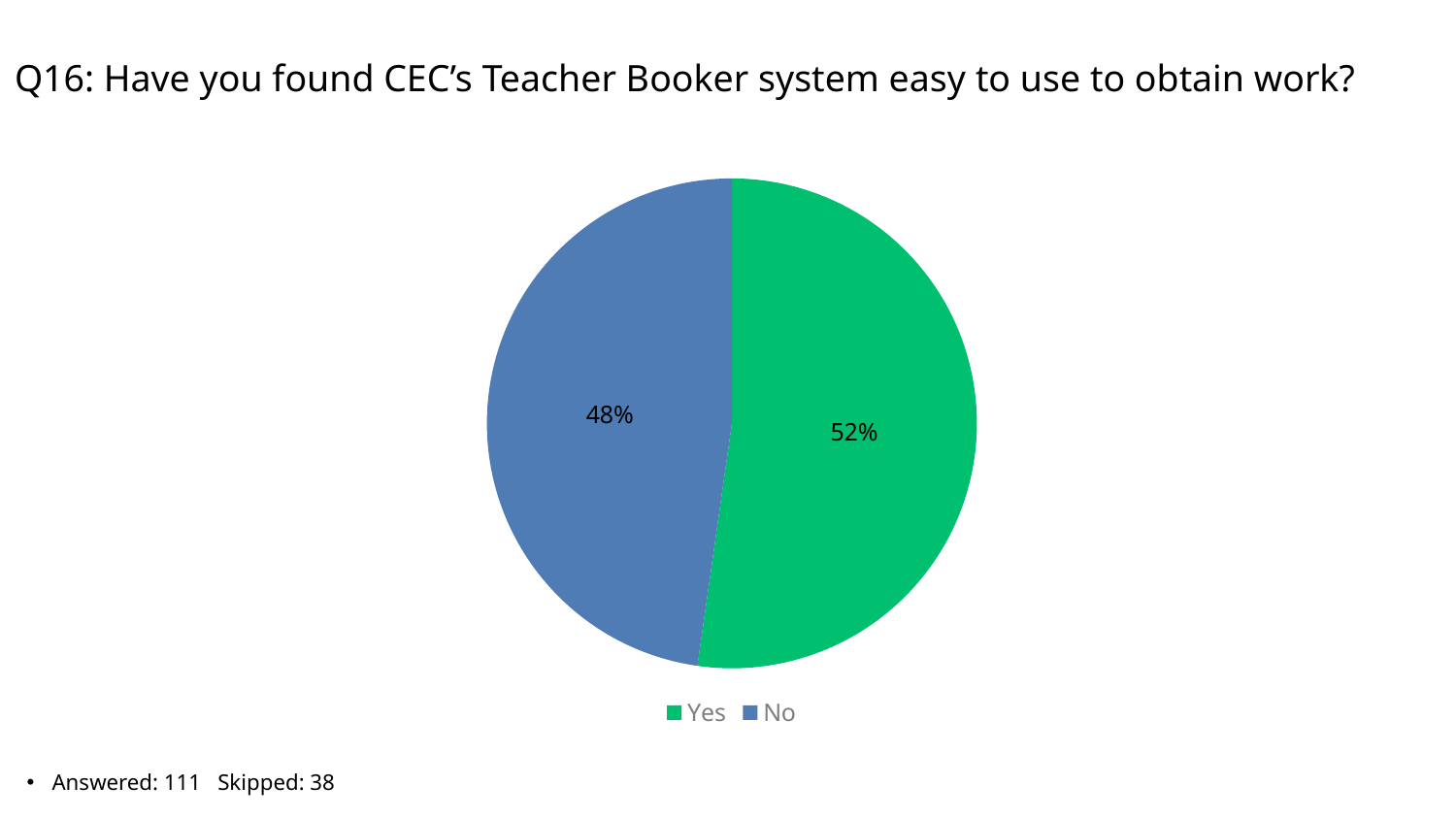
Is the share for Yes larger or smaller than the share for No? larger Which response has the larger share of the pie? Yes What percentage of respondents answered Yes? 52% What is the difference in percentage points between the Yes and No shares? 4 What share of the pie does the No slice represent? 48% How many slices does the pie chart have? 2 Which response has the smaller share of the pie? No How many respondents answered this question according to the slide? 111 How many entries does the legend list? 2 What kind of chart is shown on the slide? pie chart Which colour represents the Yes slice? green What percentage of respondents answered No? 48%